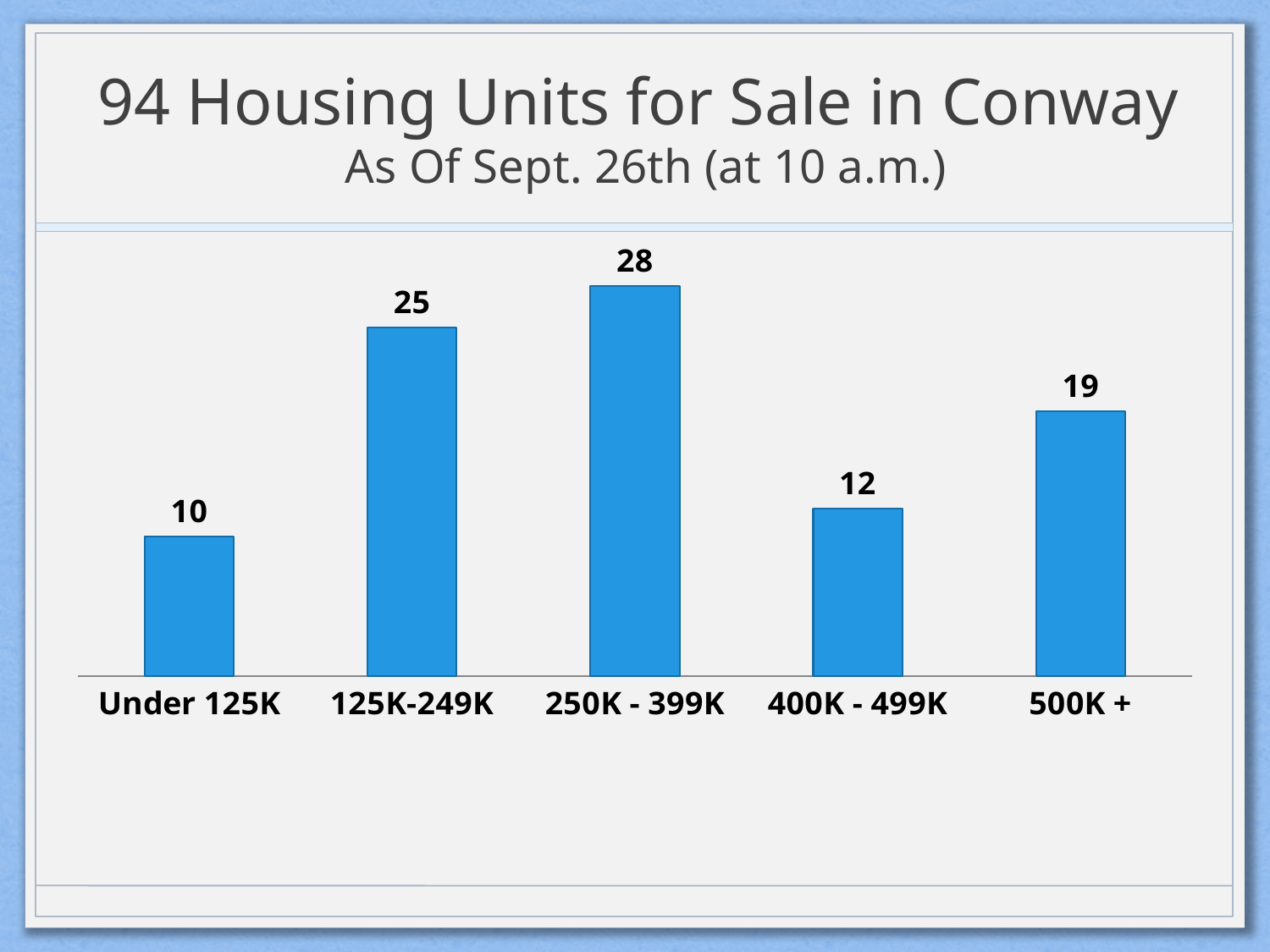
What kind of chart is shown on the slide? Bar chart Which is larger, the value for 400K - 499K or the value for 500K +? 500K + How many housing units for sale are in the Under 125K price range? 10 What is the difference between the values for 250K - 399K and 400K - 499K? 16 What is the difference between the values for 125K-249K and 500K +? 6 Which price range has the lowest number of housing units for sale? Under 125K What is the value for the 125K-249K category? 25 What is the total of all the values shown on the chart? 94 Which price range has the highest number of housing units for sale? 250K - 399K How many price range categories are shown on the chart? 5 What is the value for the 500K + category? 19 What is the title of the slide? 94 Housing Units for Sale in Conway